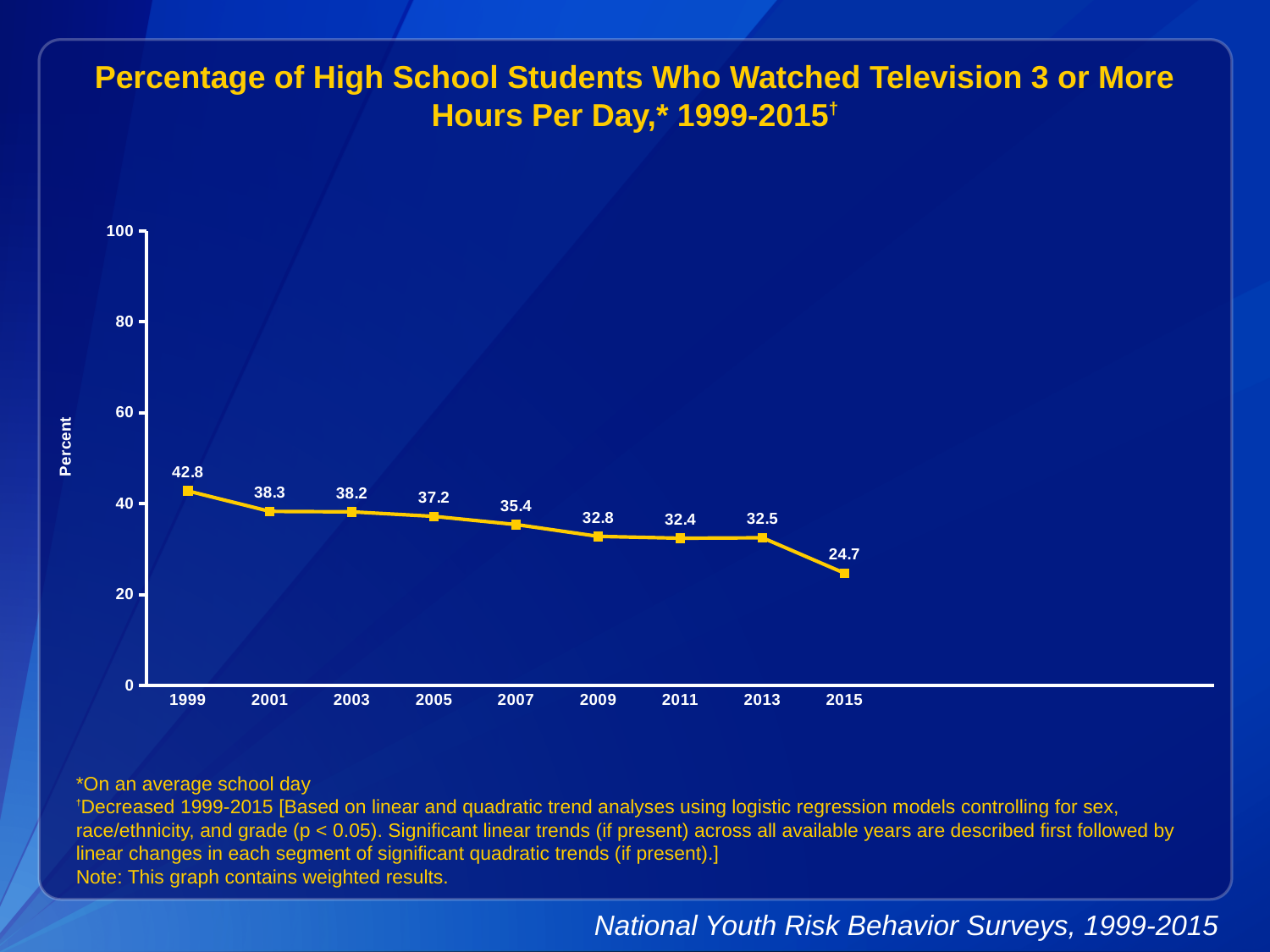
Do the values generally rise or fall from 1999 to 2015? fall Which is larger, the value for 2001 or the value for 2009? 2001 Is the value for 2005 greater or less than 40? less What is the difference between the values for 1999 and 2015? 18.1 How many years are plotted on the chart? 9 What is the value plotted for 2007? 35.4 Which year has the highest value on the chart? 1999 What is the value plotted for 2015? 24.7 What is the difference between the values for 2013 and 2015? 7.8 What kind of chart is shown on the slide? line chart What percentage of high school students watched television 3 or more hours per day in 1999? 42.8 Which year has the lowest value on the chart? 2015